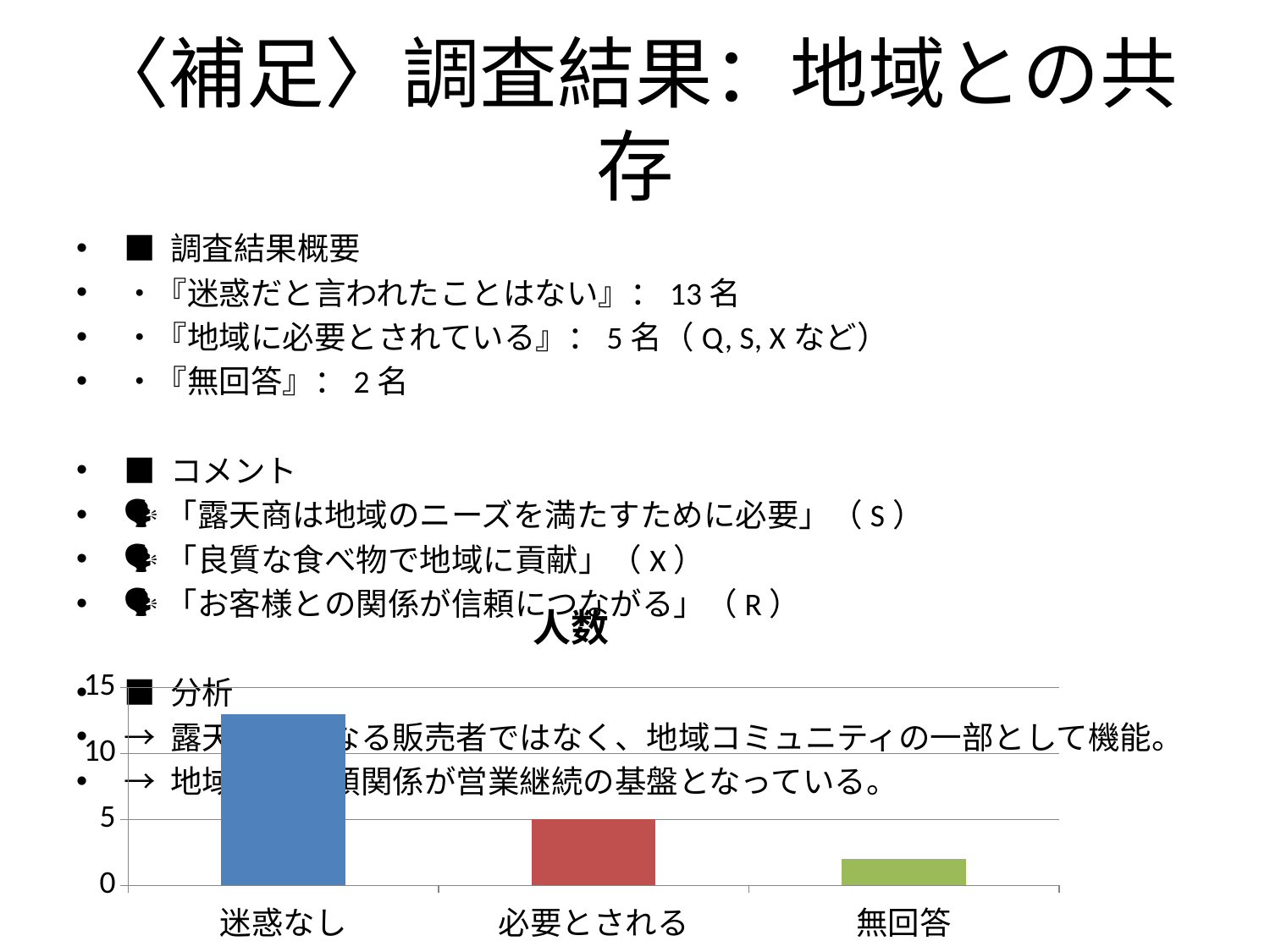
Is the value for 迷惑なし greater or less than 15? less Which is larger, the value for 必要とされる or the value for 無回答? 必要とされる What is the title of the chart? 人数 How many categories are shown on the x axis of the chart? 3 What is the highest tick value shown on the vertical axis of the chart? 15 What type of chart is shown on the slide? bar chart Is the value for 迷惑なし greater or less than 10? greater What is the value for 必要とされる in the chart? 5 Is the value for 無回答 greater or less than 5? less Which category has the lowest bar in the chart? 無回答 Which category has the highest bar in the chart? 迷惑なし Do the bar values rise or fall from left to right along the x axis? fall